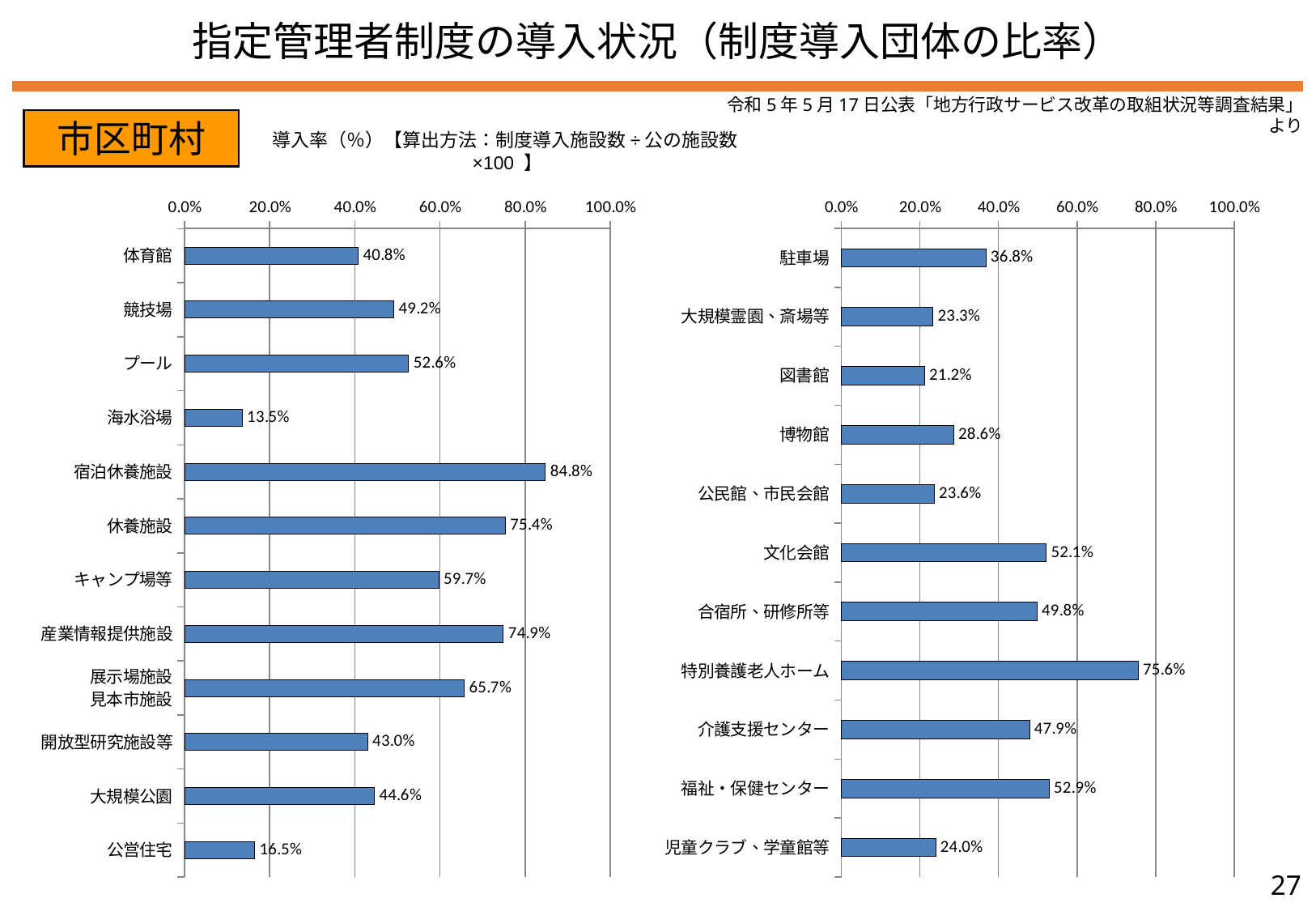
In the right chart, which category has the highest value? 特別養護老人ホーム How many categories are shown in the left chart? 12 In the left chart, what is the difference between the values for 休養施設 and 体育館? 34.6% In the right chart, what is the difference between the values for 福祉・保健センター and 児童クラブ、学童館等? 28.9% In the right chart, what is the value for 図書館? 21.2% In the right chart, which category has the lowest value? 図書館 How many categories are shown in the right chart? 11 In the left chart, which category has the lowest value? 海水浴場 In the left chart, what is the value for 宿泊休養施設? 84.8% In the left chart, is the value for キャンプ場等 greater or less than 40.0%? greater In the right chart, which is larger, the value for 文化会館 or the value for 駐車場? 文化会館 What type of chart is the right chart? Bar chart